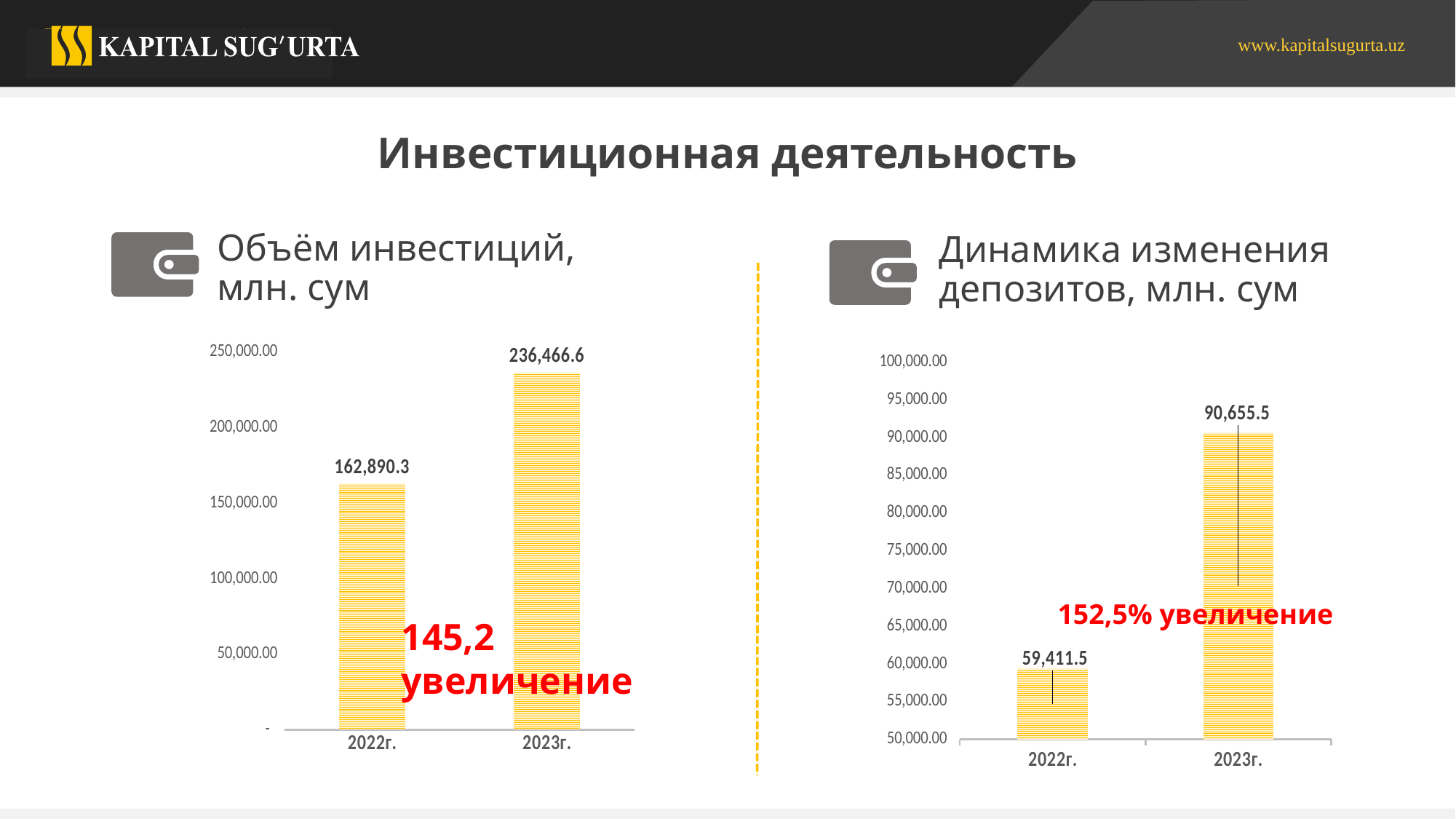
In the chart titled "Динамика изменения депозитов, млн. сум", which year has the lowest value? 2022г. In the chart titled "Объём инвестиций, млн. сум", what is the value for 2022г.? 162,890.3 In the chart titled "Объём инвестиций, млн. сум", which year has the highest value? 2023г. In the chart titled "Объём инвестиций, млн. сум", what is the difference between the 2023г. and 2022г. values? 73,576.3 In the chart titled "Динамика изменения депозитов, млн. сум", what is the value for 2023г.? 90,655.5 In the chart titled "Динамика изменения депозитов, млн. сум", what is the value for 2022г.? 59,411.5 In the chart titled "Объём инвестиций, млн. сум", is the value for 2022г. greater or less than 150,000.00? greater In the chart titled "Динамика изменения депозитов, млн. сум", what is the difference between the 2023г. and 2022г. values? 31,244.0 What kind of chart is the chart titled "Объём инвестиций, млн. сум"? bar chart In the chart titled "Динамика изменения депозитов, млн. сум", how many years are shown on the x axis? 2 In the chart titled "Динамика изменения депозитов, млн. сум", do the values rise or fall from 2022г. to 2023г.? rise In the chart titled "Объём инвестиций, млн. сум", what is the value for 2023г.? 236,466.6